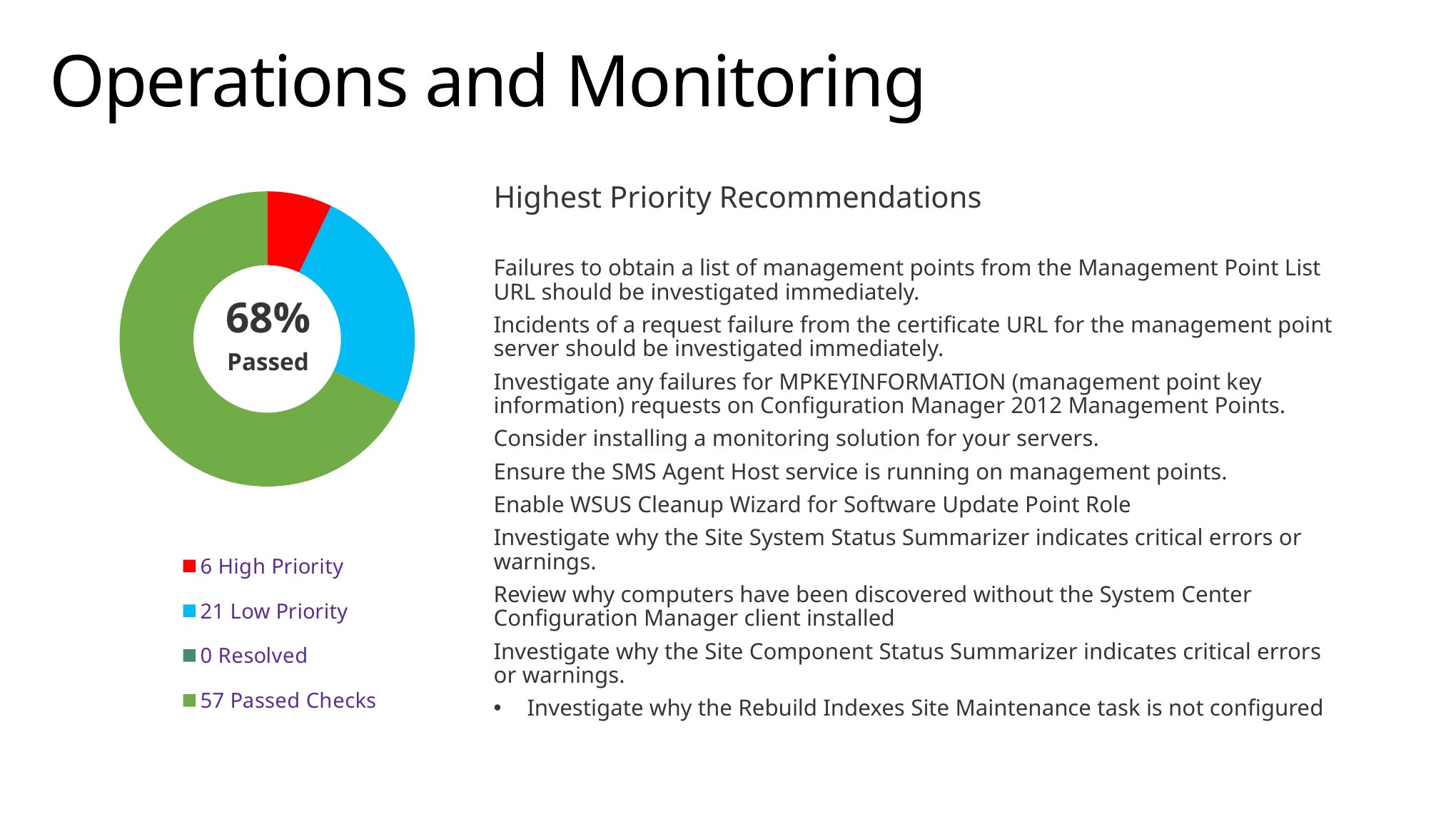
Which category has the largest value in the chart? Passed Checks What is the difference between the number of Low Priority items and High Priority items? 15 How many Resolved items does the legend show? 0 How many Passed Checks does the legend show? 57 What colour represents Low Priority in the chart? Blue Which category has the smallest value in the chart? Resolved How many High Priority items does the legend show? 6 What percentage of checks passed, according to the centre of the chart? 68% Which is larger, the number of Low Priority items or the number of High Priority items? Low Priority How many Low Priority items does the legend show? 21 What kind of chart is shown on the slide? Doughnut chart How many categories does the chart's legend list? 4